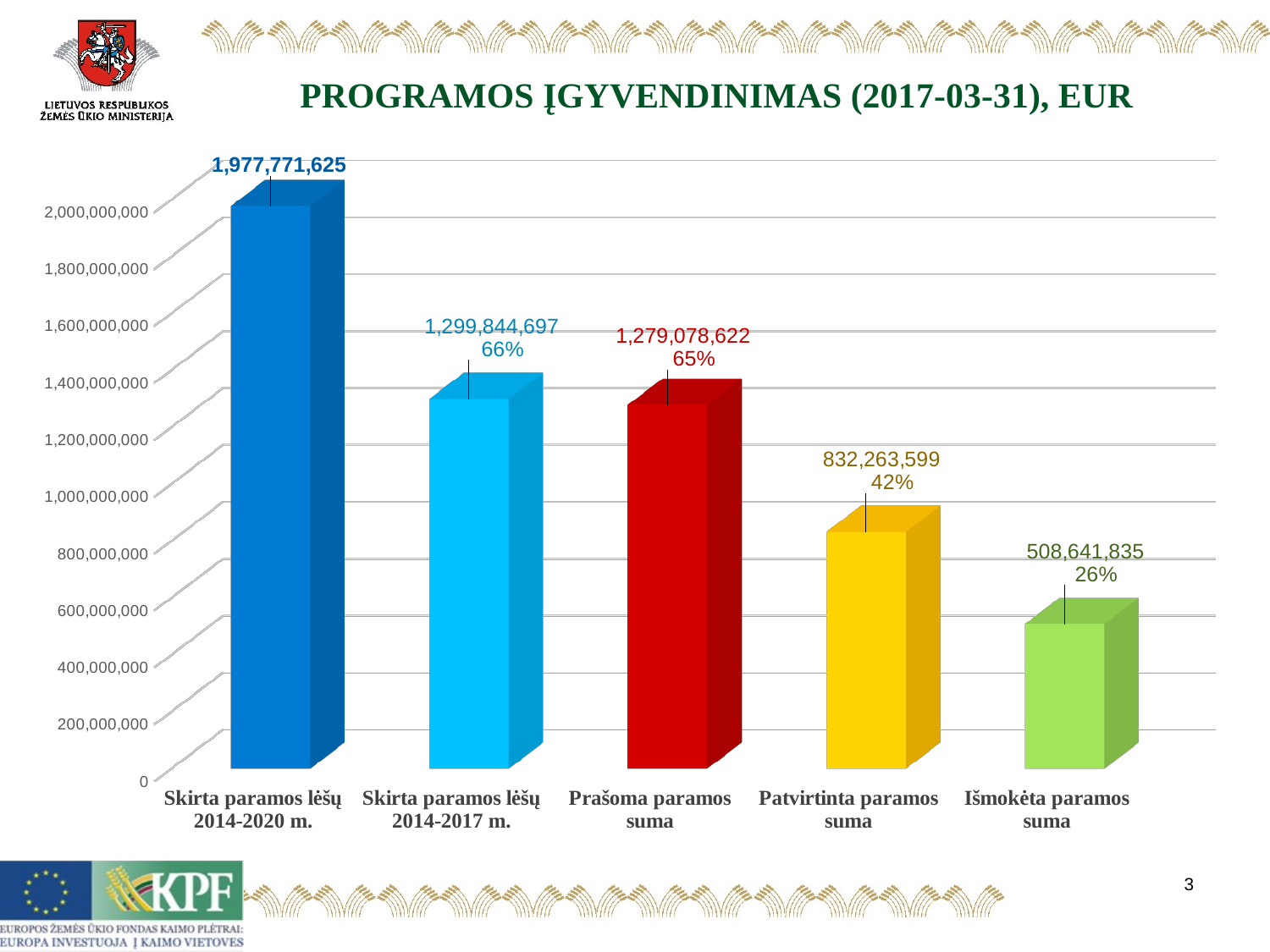
What is the value for Išmokėta paramos suma? 508,641,835 What percentage is shown above the Skirta paramos lėšų 2014-2017 m. bar? 66% What percentage is shown above the Prašoma paramos suma bar? 65% Do the values rise or fall from left to right across the categories? Fall What is the value for Patvirtinta paramos suma? 832,263,599 Which category has the highest value? Skirta paramos lėšų 2014-2020 m. Which is larger, Patvirtinta paramos suma or Išmokėta paramos suma? Patvirtinta paramos suma What is the difference between Patvirtinta paramos suma and Išmokėta paramos suma? 323,621,764 What is the value for Skirta paramos lėšų 2014-2020 m.? 1,977,771,625 How many categories are shown in the chart? 5 Which category has the lowest value? Išmokėta paramos suma What kind of chart is shown on the slide? Bar chart